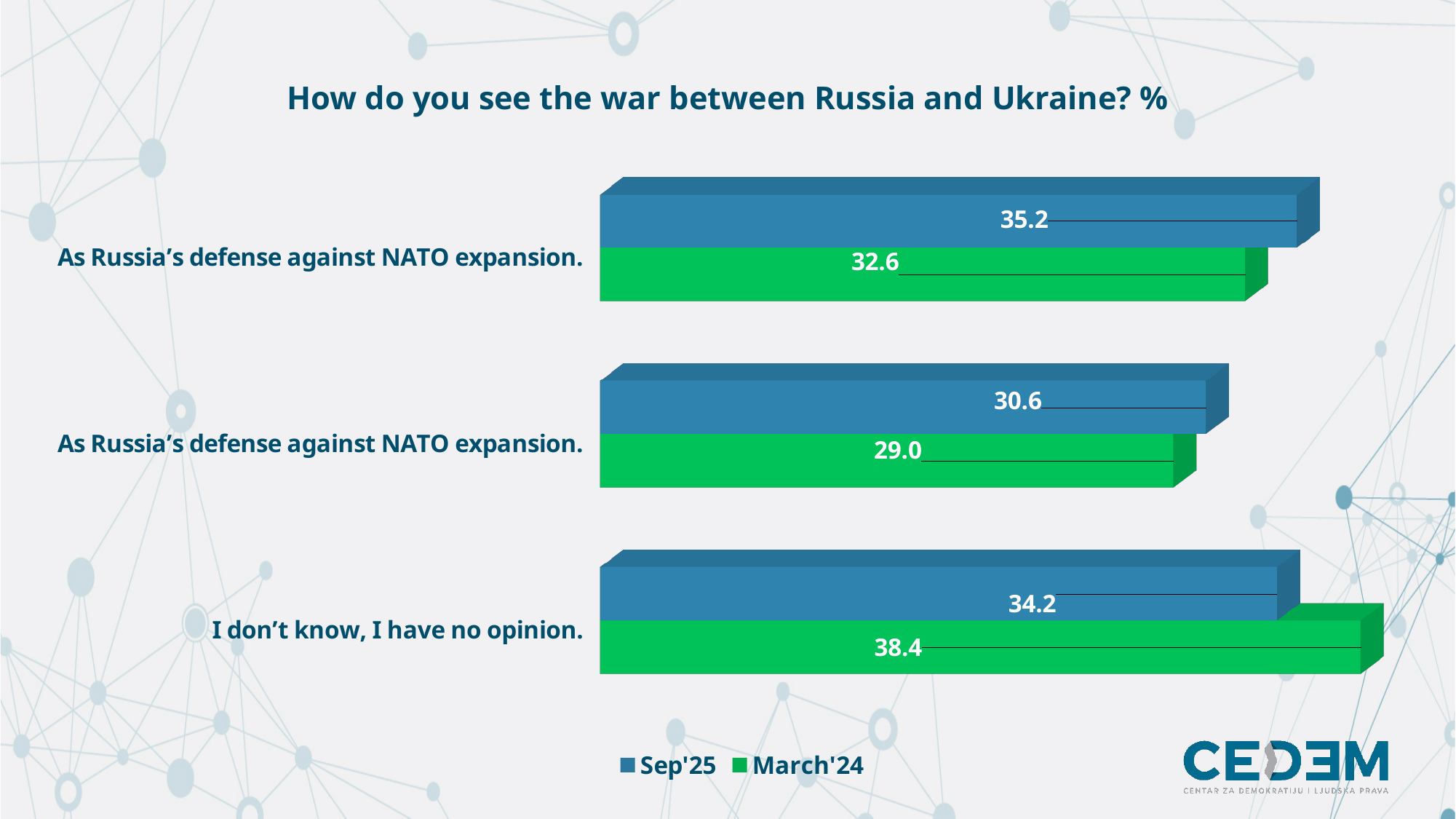
For the top pair of bars, what is the difference between the Sep'25 and March'24 values? 2.6 Which category has the highest March'24 value? I don't know, I have no opinion. What is the March'24 value for the middle pair of bars on the chart? 29.0 What is the Sep'25 value for "I don't know, I have no opinion."? 34.2 What is the Sep'25 value for the top pair of bars on the chart? 35.2 What is the March'24 value for "I don't know, I have no opinion."? 38.4 How many categories are shown on the chart? 3 What is the lowest Sep'25 value shown on the chart? 30.6 What kind of chart is shown on the slide? Bar chart For "I don't know, I have no opinion.", what is the difference between the March'24 and Sep'25 values? 4.2 For "I don't know, I have no opinion.", which is larger: the Sep'25 value or the March'24 value? March'24 How many series does the legend list? 2